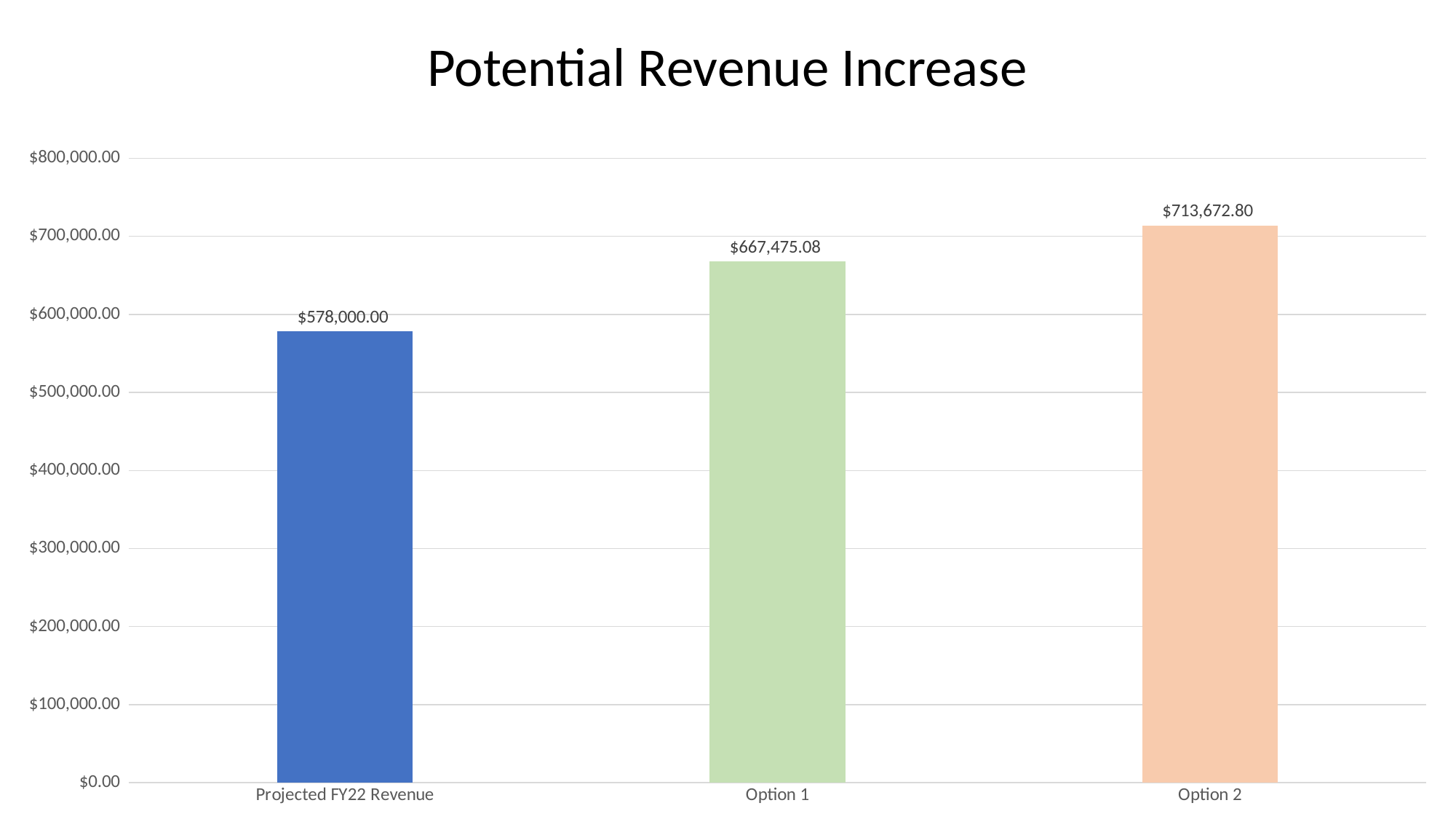
What is the difference between Option 2 and Projected FY22 Revenue? $135,672.80 What kind of chart is shown on the slide? bar chart Which category has the lowest value? Projected FY22 Revenue What is the value for Option 1? $667,475.08 What is the title of the chart? Potential Revenue Increase Is the value for Option 1 greater or less than $700,000.00? less What is the value for Option 2? $713,672.80 What is the value for Projected FY22 Revenue? $578,000.00 Which is larger, Option 1 or Option 2? Option 2 What is the difference between Option 1 and Projected FY22 Revenue? $89,475.08 Which category has the highest value? Option 2 How many categories are shown on the chart? 3